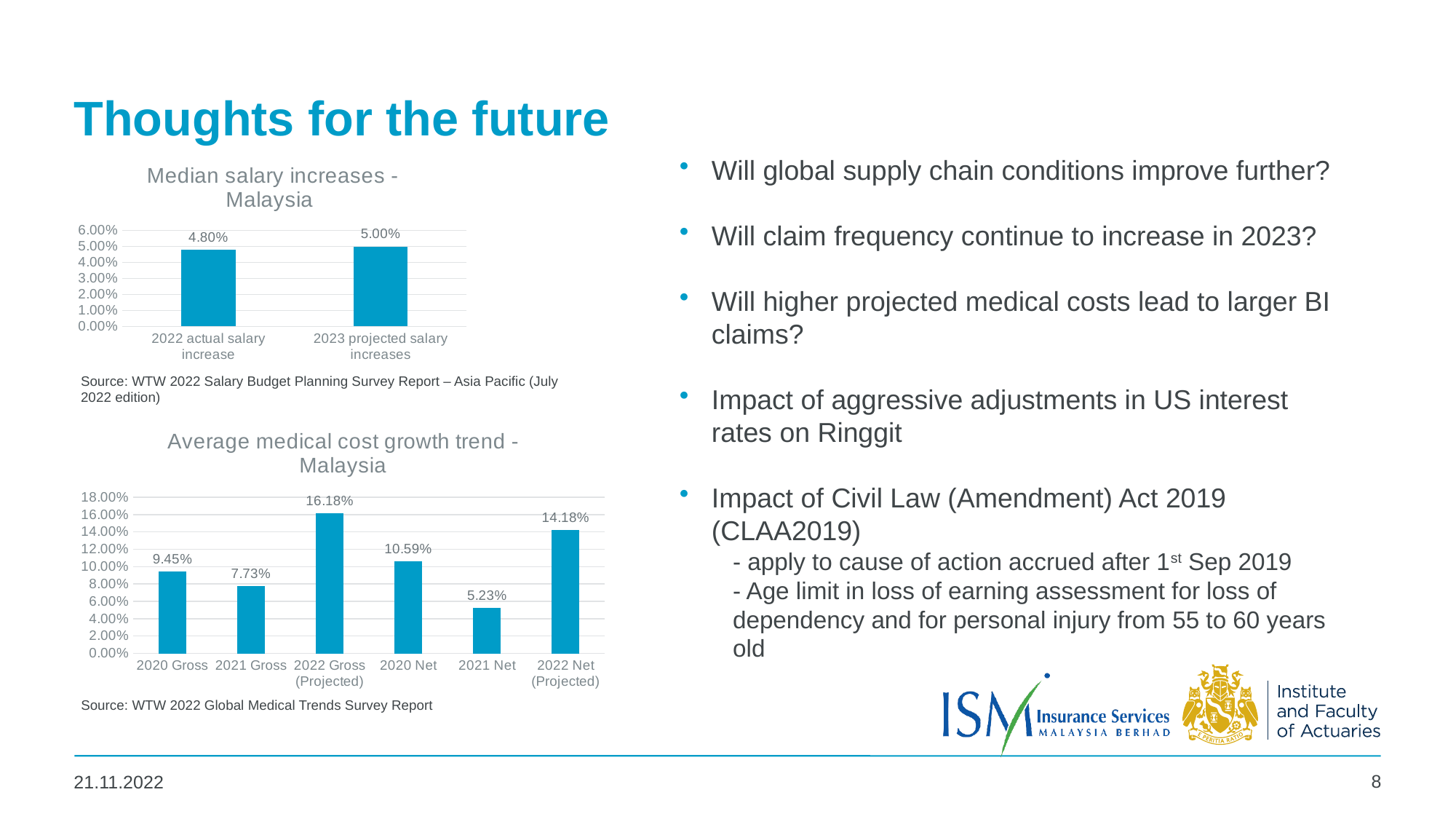
In the 'Average medical cost growth trend - Malaysia' chart, which category has the lowest value? 2021 Net In the 'Median salary increases - Malaysia' chart, what is the difference between the 2023 projected and 2022 actual values? 0.20% In the 'Median salary increases - Malaysia' chart, how many categories are plotted? 2 What kind of chart is the 'Average medical cost growth trend - Malaysia' chart? Bar chart In the 'Median salary increases - Malaysia' chart, what is the value for 2022 actual salary increase? 4.80% In the 'Average medical cost growth trend - Malaysia' chart, which is larger: 2021 Gross or 2020 Net? 2020 Net In the 'Average medical cost growth trend - Malaysia' chart, what is the difference between 2020 Net and 2020 Gross? 1.14% In the 'Median salary increases - Malaysia' chart, what is the value for 2023 projected salary increases? 5.00% In the 'Average medical cost growth trend - Malaysia' chart, what is the value for 2022 Gross (Projected)? 16.18% In the 'Average medical cost growth trend - Malaysia' chart, how many categories are plotted? 6 In the 'Average medical cost growth trend - Malaysia' chart, which category has the highest value? 2022 Gross (Projected) In the 'Average medical cost growth trend - Malaysia' chart, what is the value for 2021 Net? 5.23%